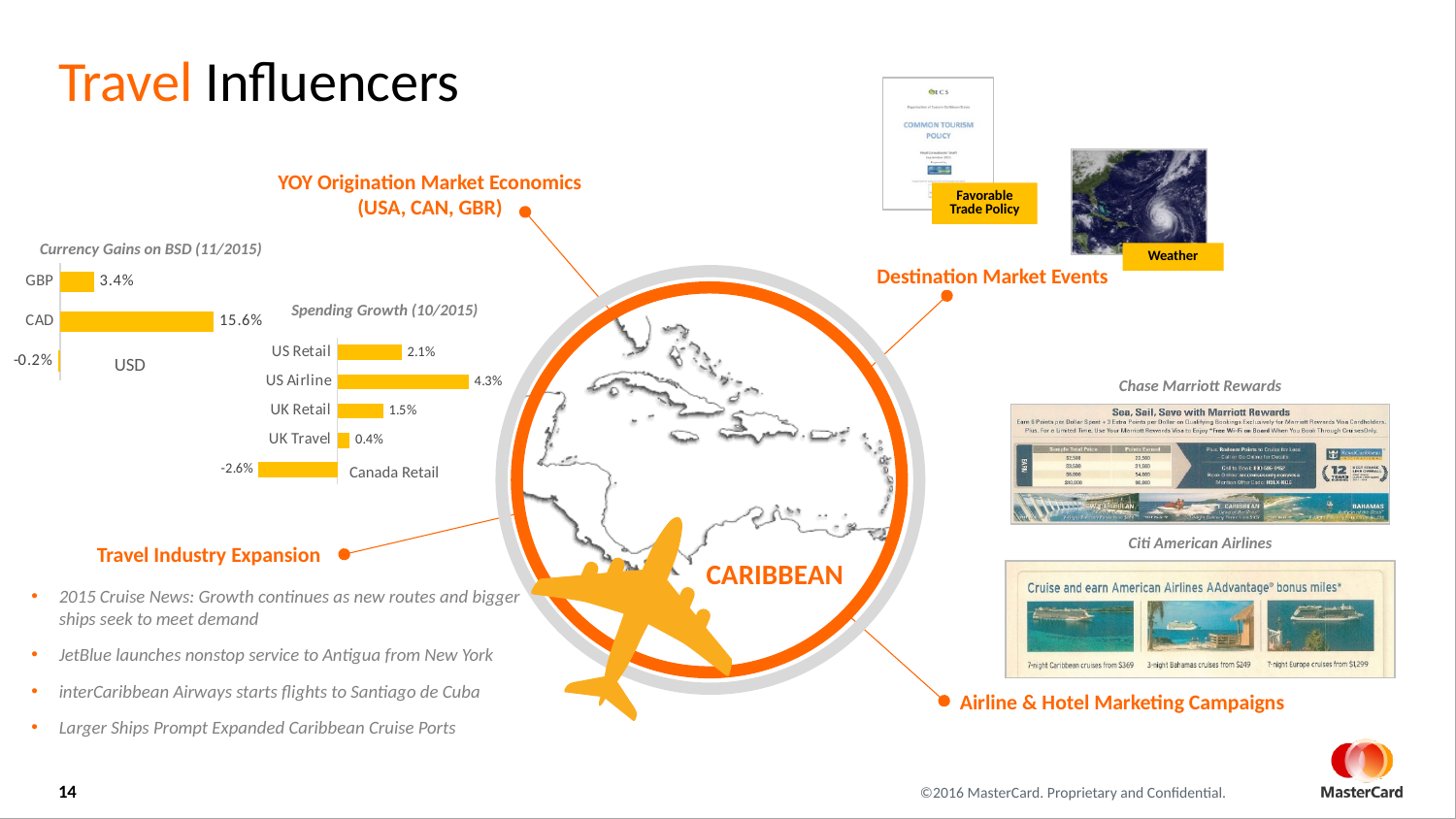
In the Spending Growth (10/2015) chart, what is the value for US Airline? 4.3% In the Currency Gains on BSD (11/2015) chart, which currency has the highest value? CAD In the Currency Gains on BSD (11/2015) chart, what is the value for USD? -0.2% In the Spending Growth (10/2015) chart, which is larger, US Retail or UK Retail? US Retail In the Spending Growth (10/2015) chart, what is the value for Canada Retail? -2.6% In the Currency Gains on BSD (11/2015) chart, what is the difference between the CAD and GBP values? 12.2% In the Spending Growth (10/2015) chart, which category has the lowest value? Canada Retail In the Currency Gains on BSD (11/2015) chart, what is the value for CAD? 15.6% In the Currency Gains on BSD (11/2015) chart, what is the value for GBP? 3.4% In the Currency Gains on BSD (11/2015) chart, how many currencies are shown? 3 What type of chart is the Spending Growth (10/2015) chart? Bar chart In the Spending Growth (10/2015) chart, how many categories are shown? 5